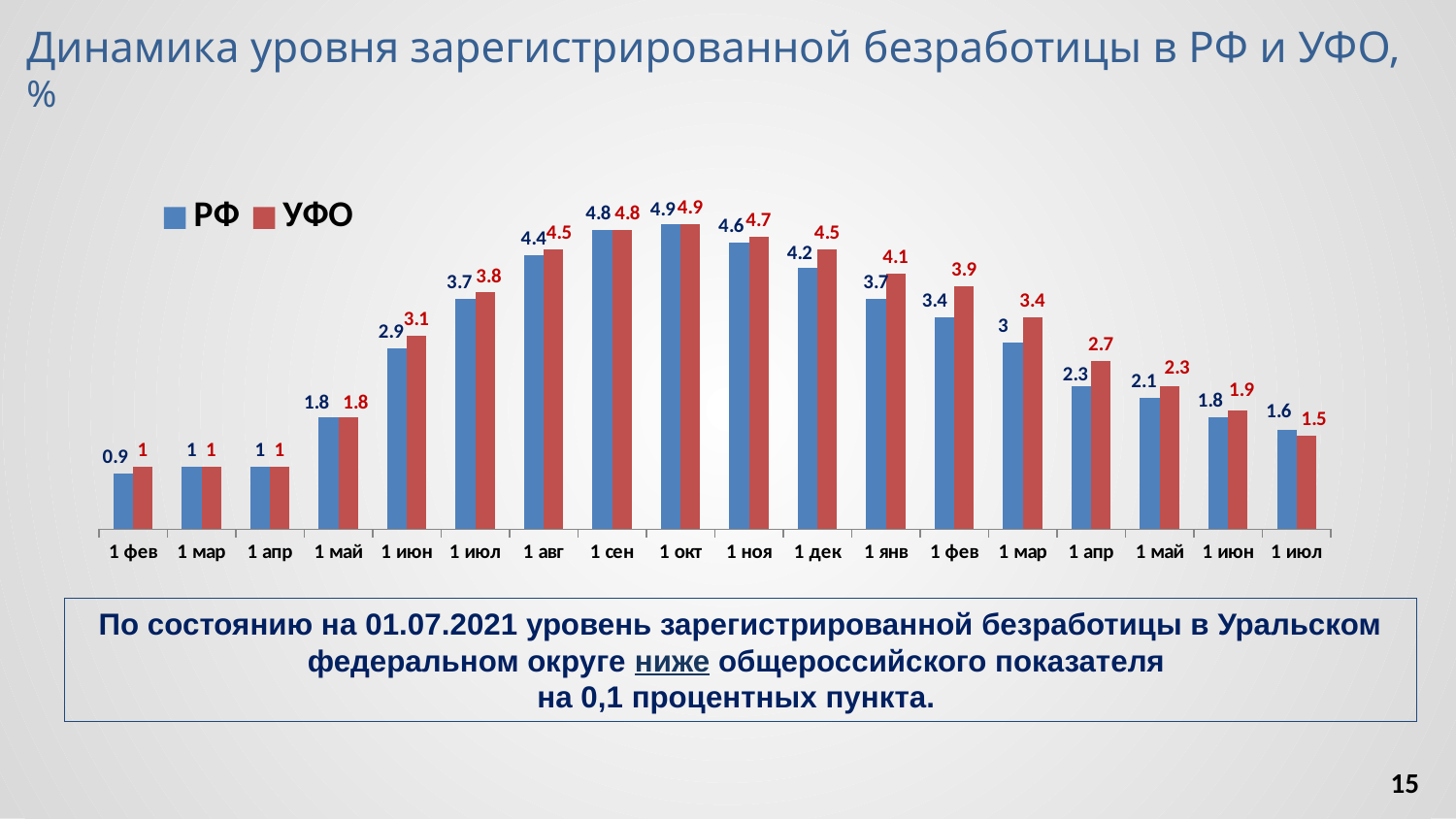
What is the difference between УФО and РФ at 1 апр (the second 1 апр, on the right side of the chart)? 0.4 At 1 ноя, which series has the larger value, РФ or УФО? УФО How many series does the legend list? 2 What are the two series named in the legend? РФ and УФО What type of chart is shown on the slide? bar chart What is the value for РФ at the last category on the x axis (the second 1 июл)? 1.6 How many categories (dates) are shown on the x axis? 18 At which date does the РФ series reach its highest value? 1 окт What is the value for УФО at 1 дек? 4.5 What is the lowest value shown for the РФ series? 0.9 What is the value for УФО at 1 янв? 4.1 What is the value for РФ at 1 окт? 4.9